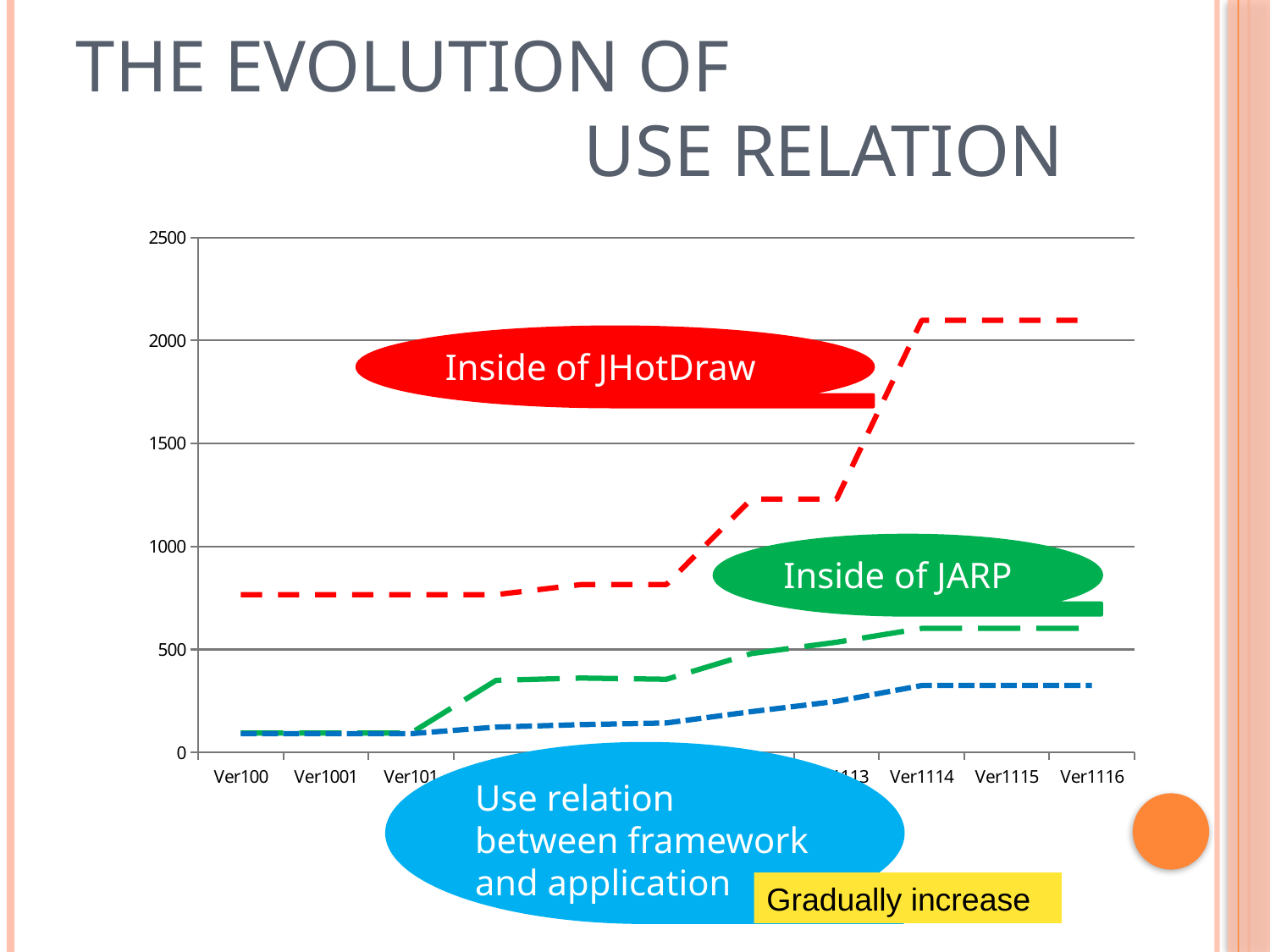
At Ver1116, which is larger: Inside of JHotDraw or Inside of JARP? Inside of JHotDraw Is the value of the Use relation between framework and application line at Ver1116 greater or less than 500? less Is the value of the Inside of JHotDraw line at Ver1116 greater or less than 2000? greater What kind of chart is shown on the slide? line chart Is the value of the Inside of JHotDraw line at Ver100 greater or less than 1000? less What colour is the line labelled Inside of JARP? green Which series has the highest value at Ver1116? Inside of JHotDraw At Ver1116, which is larger: Inside of JARP or Use relation between framework and application? Inside of JARP Does the Inside of JHotDraw line rise or fall from Ver100 to Ver1116? rise How many lines (series) are plotted on the chart? 3